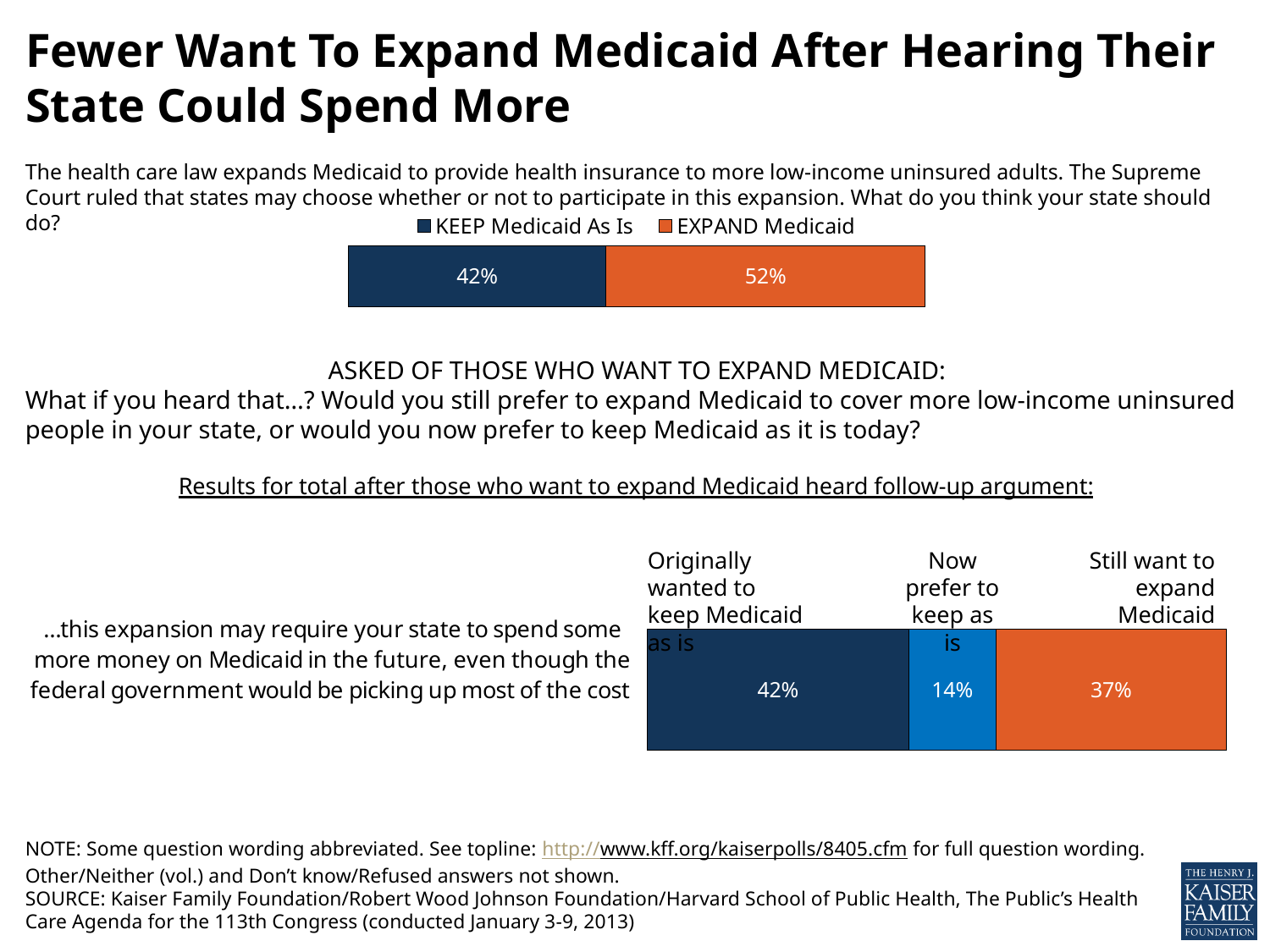
In the bottom chart, what is the difference between 'Still want to expand Medicaid' and 'Now prefer to keep as is'? 23 percentage points In the top chart, what percentage say EXPAND Medicaid? 52% In the top chart, what is the difference between the EXPAND Medicaid and KEEP Medicaid As Is percentages? 10 percentage points How many segments does the bottom chart's bar have? 3 What type of chart is the top chart? Stacked bar chart In the bottom chart, what percentage 'Originally wanted to keep Medicaid as is'? 42% In the bottom chart, which segment is the smallest? Now prefer to keep as is How many series does the legend of the top chart list? 2 In the top chart, which response is larger, KEEP Medicaid As Is or EXPAND Medicaid? EXPAND Medicaid In the bottom chart, what percentage 'Now prefer to keep as is'? 14% In the bottom chart, what percentage 'Still want to expand Medicaid'? 37% In the top chart, what percentage say KEEP Medicaid As Is? 42%